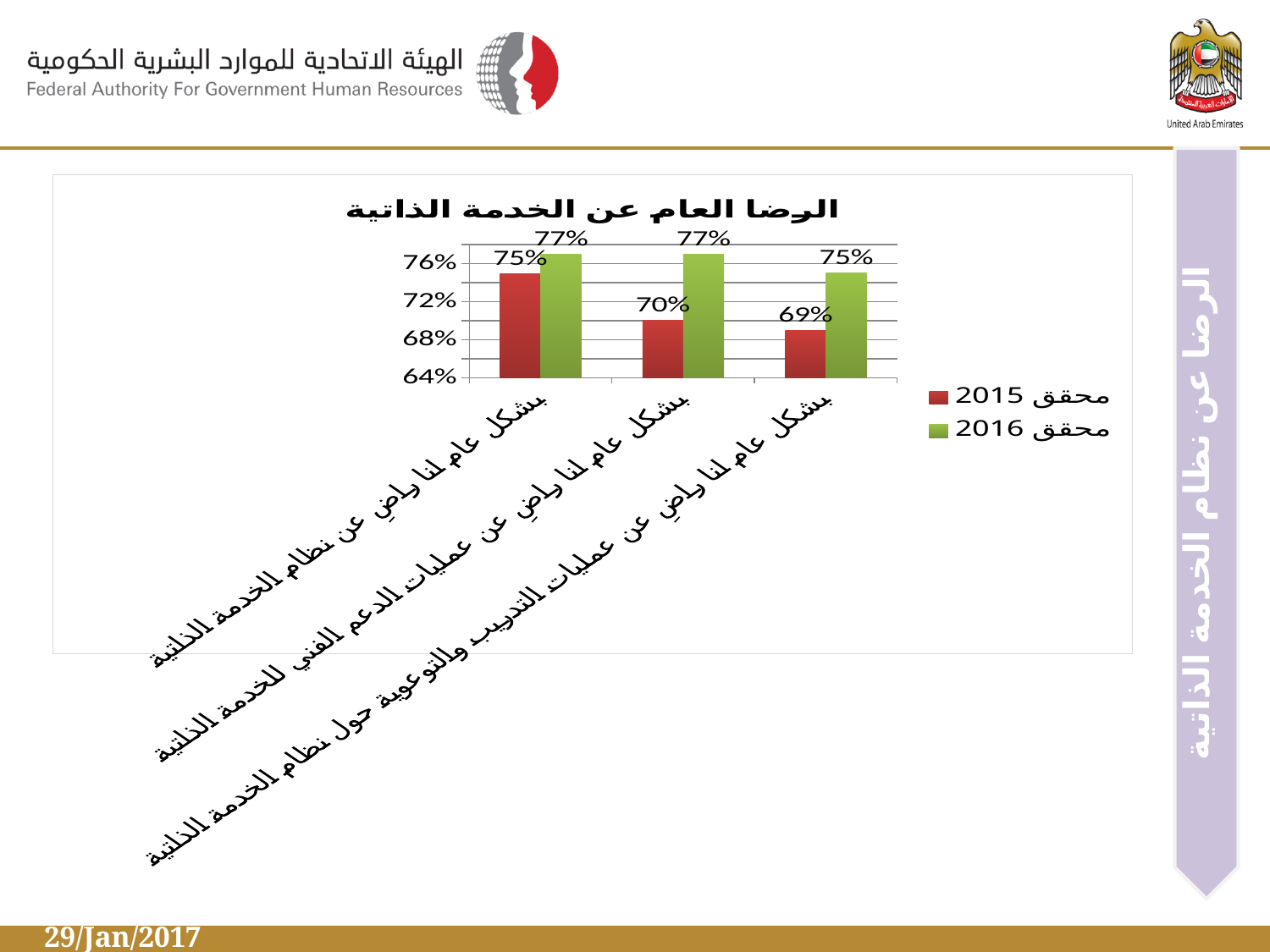
For the third category (التدريب والتوعية), which is larger: محقق 2015 or محقق 2016? محقق 2016 How many series does the legend list? 2 What is the title of the chart? الرضا العام عن الخدمة الذاتية Which colour represents محقق 2016 in the chart? green What is the difference between محقق 2016 and محقق 2015 for the second category (الدعم الفني)? 7% Which category has the lowest value for محقق 2015? بشكل عام أنا راضٍ عن عمليات التدريب والتوعية حول نظام الخدمة الذاتية (the third category) How many categories are shown on the x axis? 3 What is the difference between محقق 2016 and محقق 2015 for the first category (نظام الخدمة الذاتية)? 2% What is the value of محقق 2015 for the third (rightmost) category, about التدريب والتوعية? 69% What is the value of محقق 2015 for the first (leftmost) category, بشكل عام أنا راضٍ عن نظام الخدمة الذاتية? 75% What is the value of محقق 2016 for the second category, بشكل عام أنا راضٍ عن عمليات الدعم الفني للخدمة الذاتية? 77% What type of chart is shown on the slide? bar chart